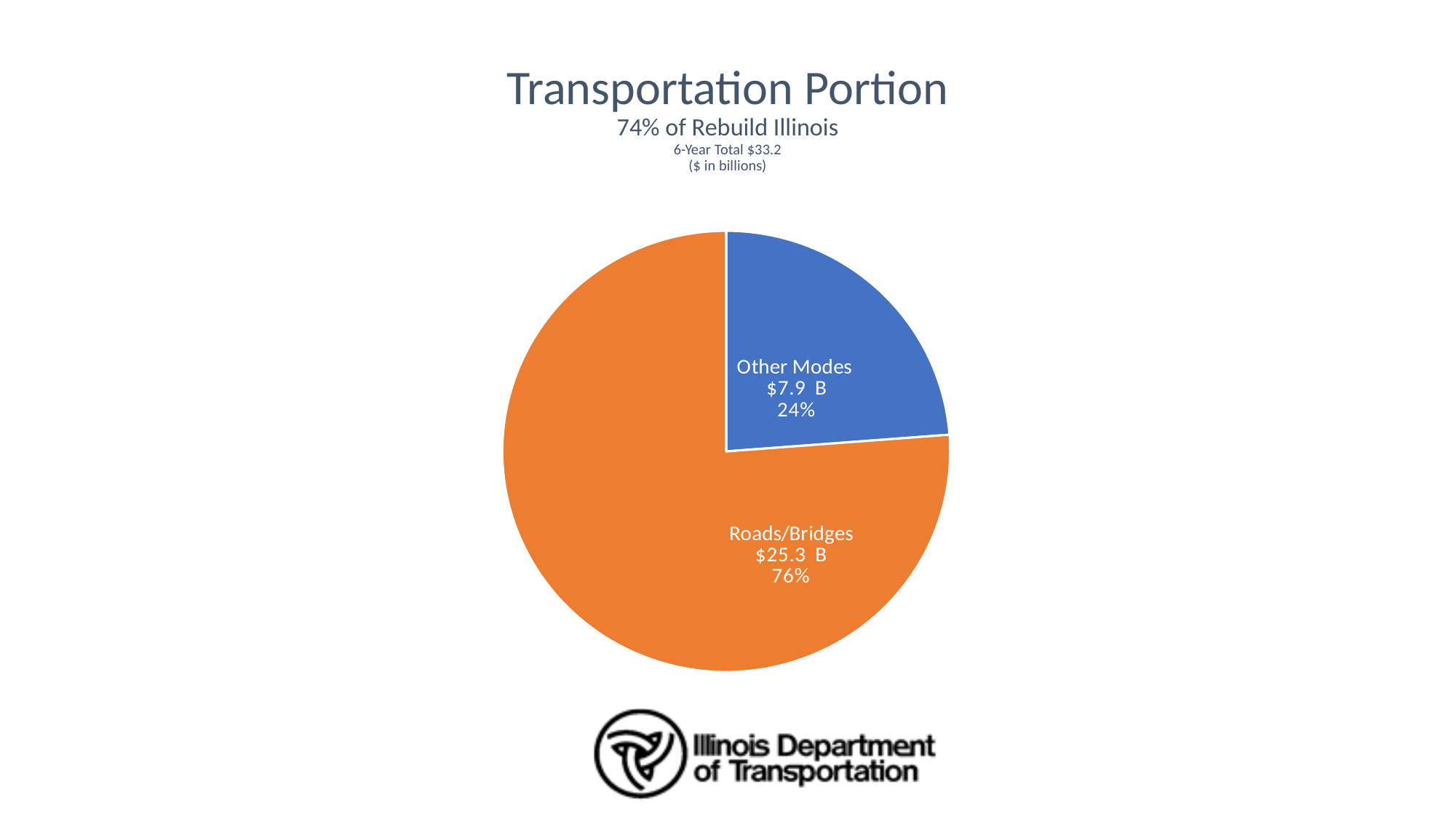
What share of the pie does Roads/Bridges represent? 76% What is the difference in dollars between Roads/Bridges and Other Modes? $17.4 B Which slice is the smallest? Other Modes What is the title of the chart? Transportation Portion Which is larger, Roads/Bridges or Other Modes? Roads/Bridges What colour is the Other Modes slice? blue Which slice is the largest? Roads/Bridges What share of the pie does Other Modes represent? 24% What is the dollar value for Roads/Bridges? $25.3 B How many slices does the pie chart have? 2 What is the dollar value for Other Modes? $7.9 B What kind of chart is shown on the slide? pie chart